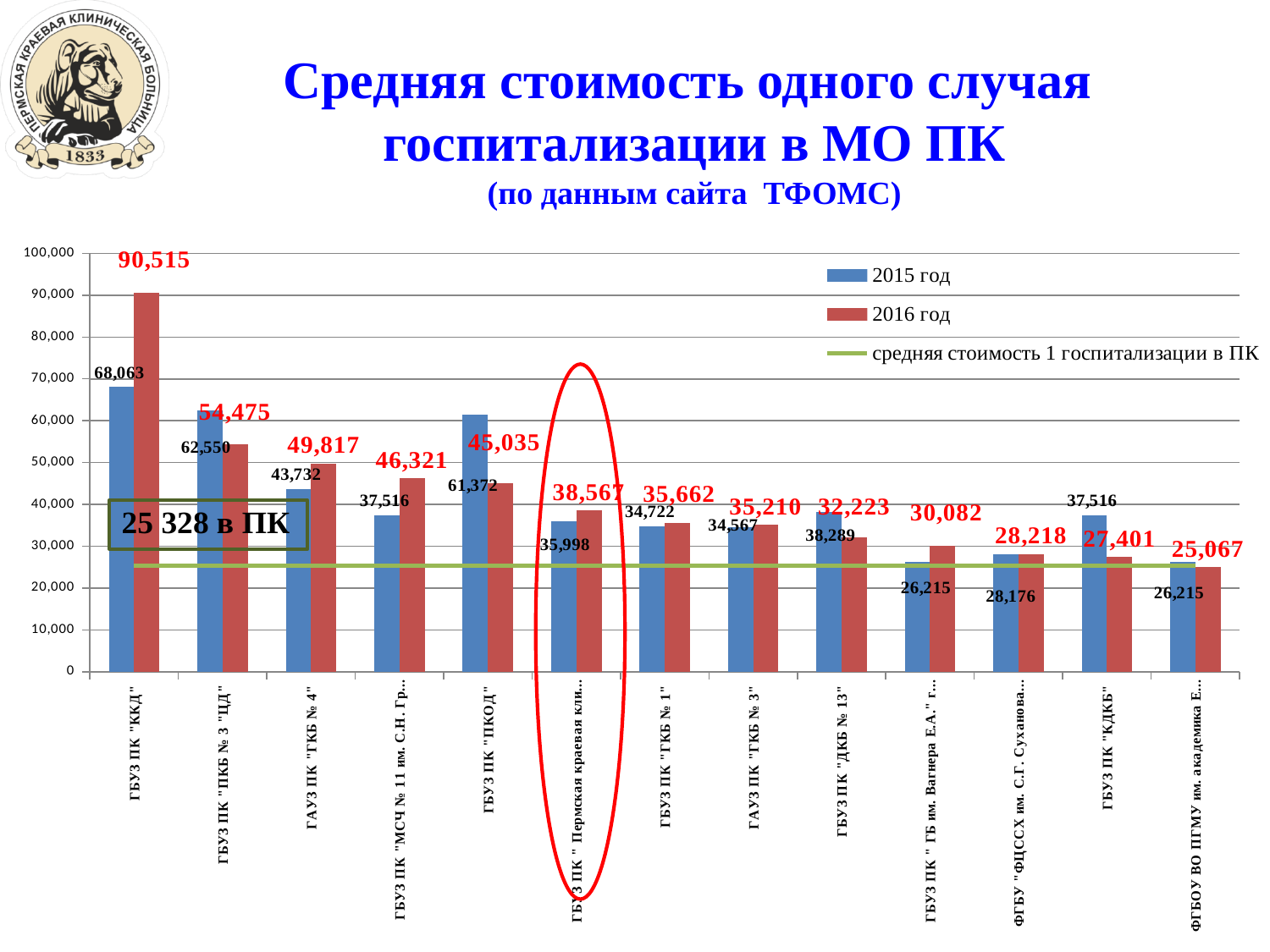
By how much did the value for ГБУЗ ПК "ККД" increase from 2015 год to 2016 год? 22,452 Which organisation has the highest 2016 год value? ГБУЗ ПК "ККД" What is the 2016 год value for ГБУЗ ПК "ККД"? 90,515 What is the difference between the 2016 год and 2015 год values for ГАУЗ ПК "ГКБ № 4"? 6,085 How many organisations are shown on the x axis? 13 What value is given for the average cost of one hospitalisation in ПК (the green line)? 25 328 What is the 2015 год value for ГБУЗ ПК "ПКОД"? 61,372 What is the 2016 год value for ГБУЗ ПК "ДКБ № 13"? 32,223 How many entries does the legend list? 3 Which organisation has the lowest 2016 год value? ФГБОУ ВО ПГМУ им. академика Е... What type of chart is shown on the slide? Bar chart For ГБУЗ ПК "ПКОД", which year has the larger value, 2015 год or 2016 год? 2015 год